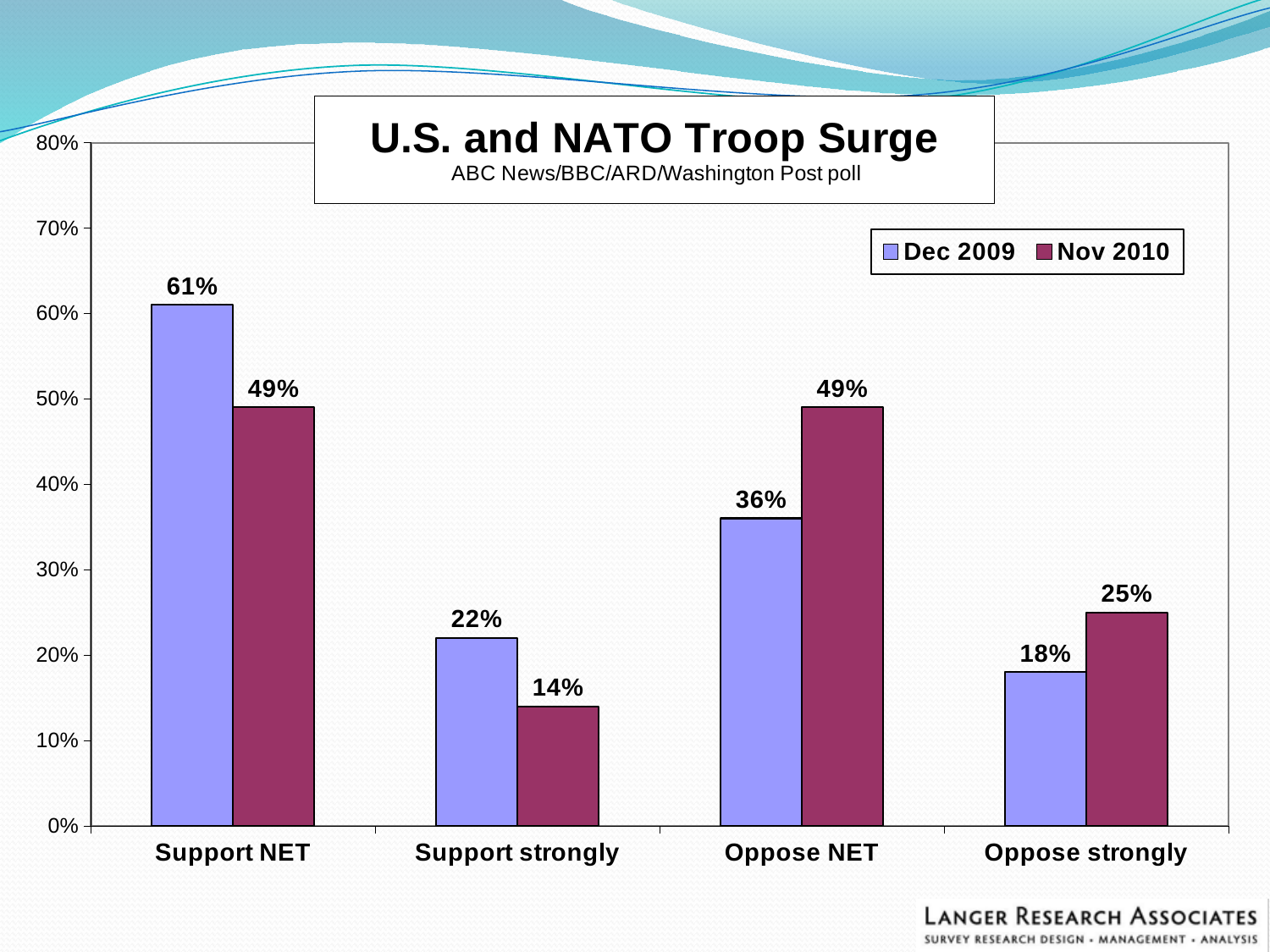
How many categories are shown on the x axis? 4 Which category has the lowest Nov 2010 value? Support strongly What is the Nov 2010 value for Oppose strongly? 25% What is the difference between the Dec 2009 and Nov 2010 values for Oppose NET? 13% Which is larger for Support strongly: the Dec 2009 value or the Nov 2010 value? Dec 2009 What is the title of the chart? U.S. and NATO Troop Surge What is the Dec 2009 value for Support NET? 61% What kind of chart is shown on the slide? Bar chart Which poll is named in the chart subtitle? ABC News/BBC/ARD/Washington Post poll What is the Nov 2010 value for Support strongly? 14% How many series does the legend list? 2 Which category has the highest Dec 2009 value? Support NET